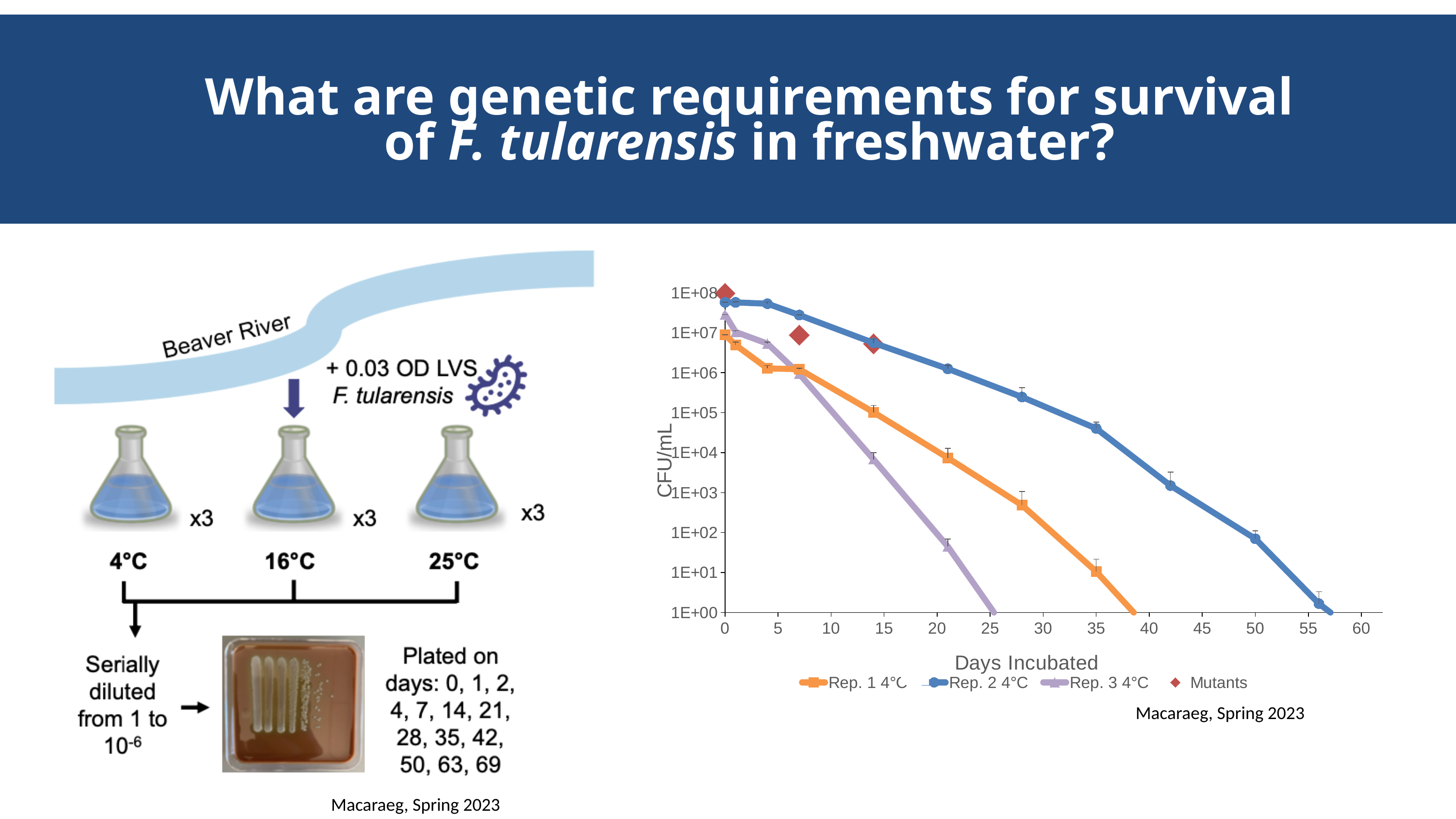
Is the value for Rep. 1 4°C at day 28 greater or less than 1E+03? less Is the value for Rep. 3 4°C at day 21 greater or less than 1E+02? less What kind of chart is shown on the slide? line chart Do the CFU/mL values for Rep. 2 4°C rise or fall as Days Incubated increases? fall Which series reaches 1E+00 CFU/mL at the earliest day? Rep. 3 4°C At day 21, which series has the larger value: Rep. 1 4°C or Rep. 2 4°C? Rep. 2 4°C What is the label of the x axis of the chart? Days Incubated How many series does the chart legend list? 4 Which series has the highest CFU/mL value at day 35? Rep. 2 4°C What is the label of the y axis of the chart? CFU/mL Is the value for Rep. 2 4°C at day 35 greater or less than 1E+04? greater